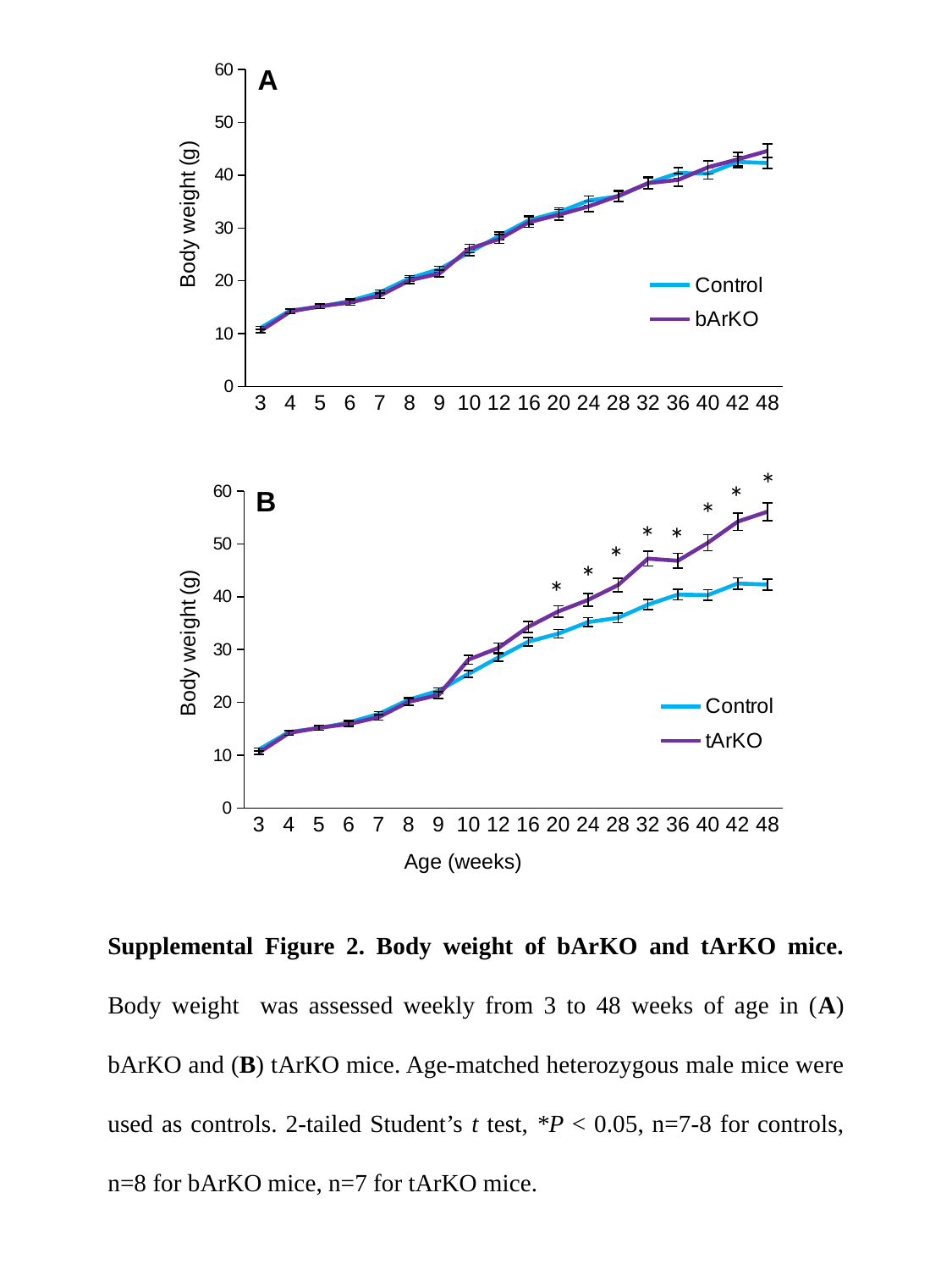
How many series does the legend of chart B list? 2 What kind of chart is chart A? line chart How many age points are plotted along the x axis of chart A? 18 In chart B, is the Control body weight at 32 weeks greater or less than 40? less In chart B, at which age in weeks is body weight lowest for both series? 3 What is the label of the y axis in chart A? Body weight (g) In chart B, do body weights rise or fall as age increases from 3 to 48 weeks? rise In chart B, is the tArKO body weight at 48 weeks greater or less than 50? greater In chart B, at 48 weeks, which series has the larger body weight, Control or tArKO? tArKO In chart A, is the Control body weight at 48 weeks greater or less than 40? greater In chart B, at 28 weeks, which series has the larger body weight, Control or tArKO? tArKO Which series is shown in purple in chart A? bArKO